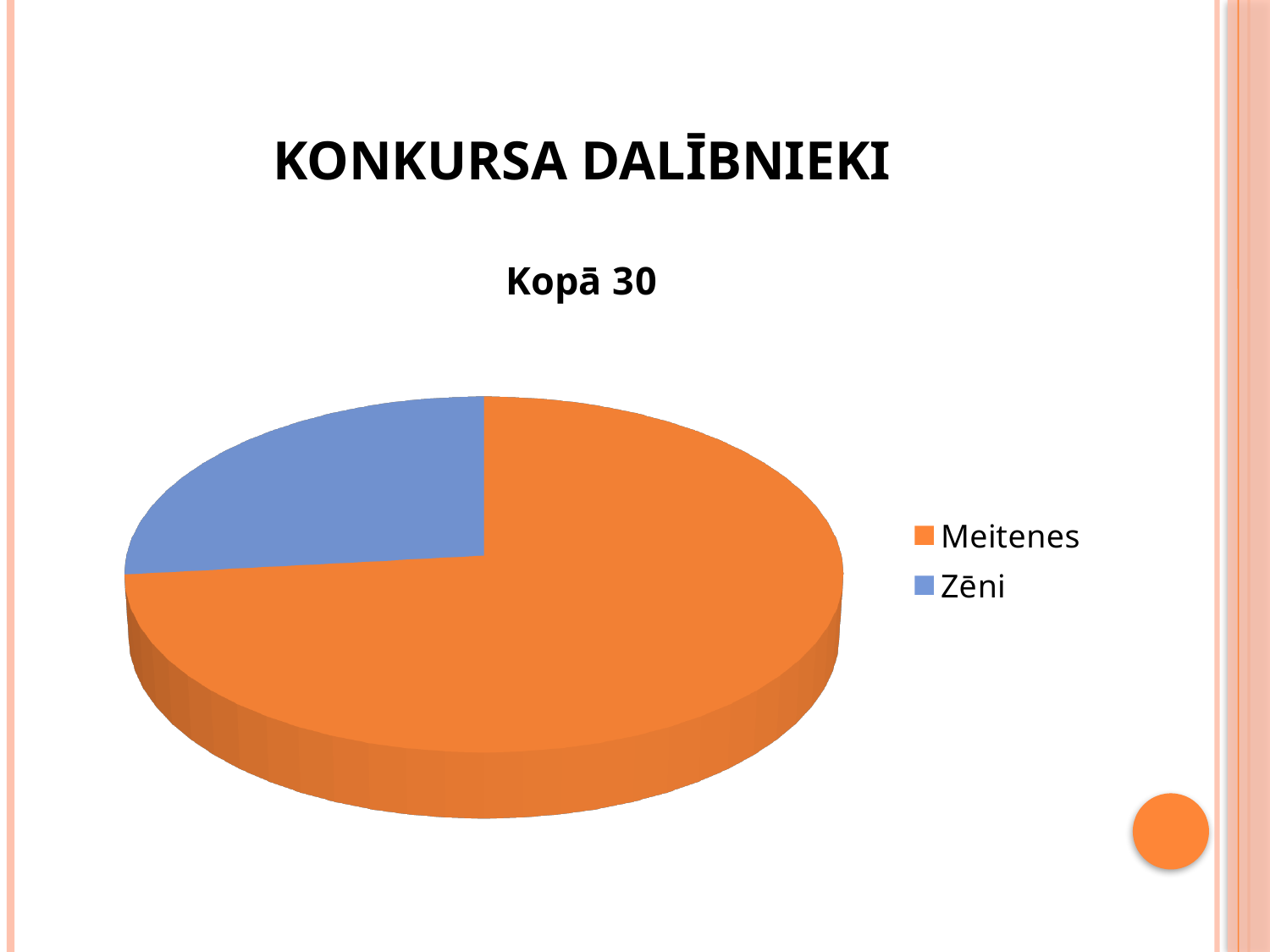
What colour is the Zēni slice in the pie chart? blue What is the title of the pie chart? Kopā 30 Which slice is larger, Meitenes or Zēni? Meitenes What kind of chart is shown on the slide? pie chart Which category has the smallest slice in the pie chart? Zēni Which category has the largest slice in the pie chart? Meitenes How many slices does the pie chart have? 2 How many entries does the legend of the pie chart list? 2